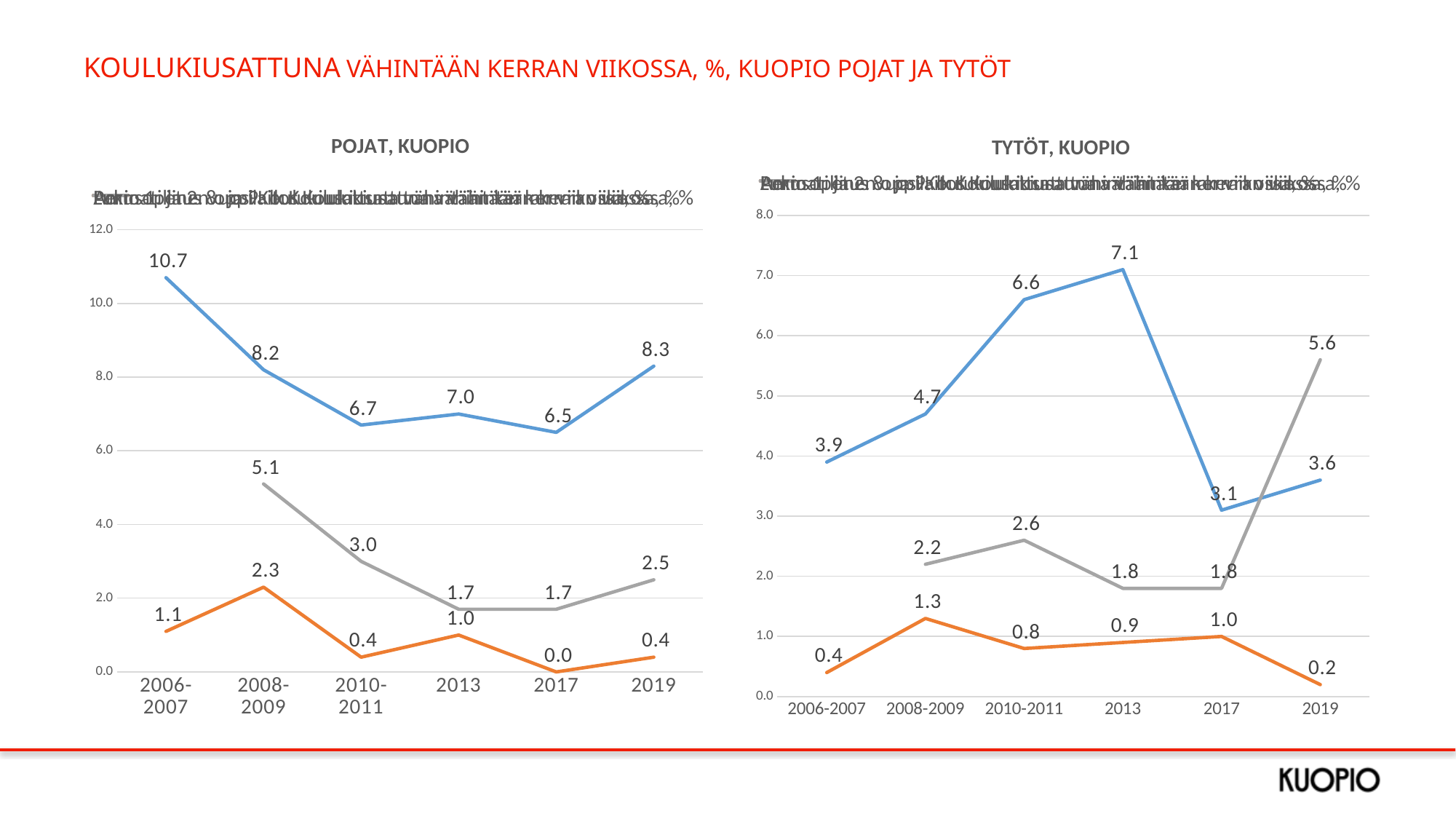
In the POJAT, KUOPIO chart, is the blue line's value for 2008-2009 greater or less than 8.0? greater In the POJAT, KUOPIO chart, what is the difference between the blue line's values for 2006-2007 and 2019? 2.4 What kind of chart is the POJAT, KUOPIO chart? line chart In the TYTÖT, KUOPIO chart, what is the value of the grey line for 2019? 5.6 In the POJAT, KUOPIO chart, what is the value of the orange line for 2017? 0.0 How many time periods are shown on the x axis of the TYTÖT, KUOPIO chart? 6 In the POJAT, KUOPIO chart, in which period is the blue line at its lowest value? 2017 In the POJAT, KUOPIO chart, does the blue line rise or fall from 2006-2007 to 2010-2011? fall In the TYTÖT, KUOPIO chart, in which period does the blue line reach its highest value? 2013 In the TYTÖT, KUOPIO chart, what is the difference between the blue line's values for 2013 and 2017? 4.0 In the TYTÖT, KUOPIO chart, which is larger for 2019: the blue line or the grey line? the grey line In the POJAT, KUOPIO chart, what is the value of the blue line for 2006-2007? 10.7